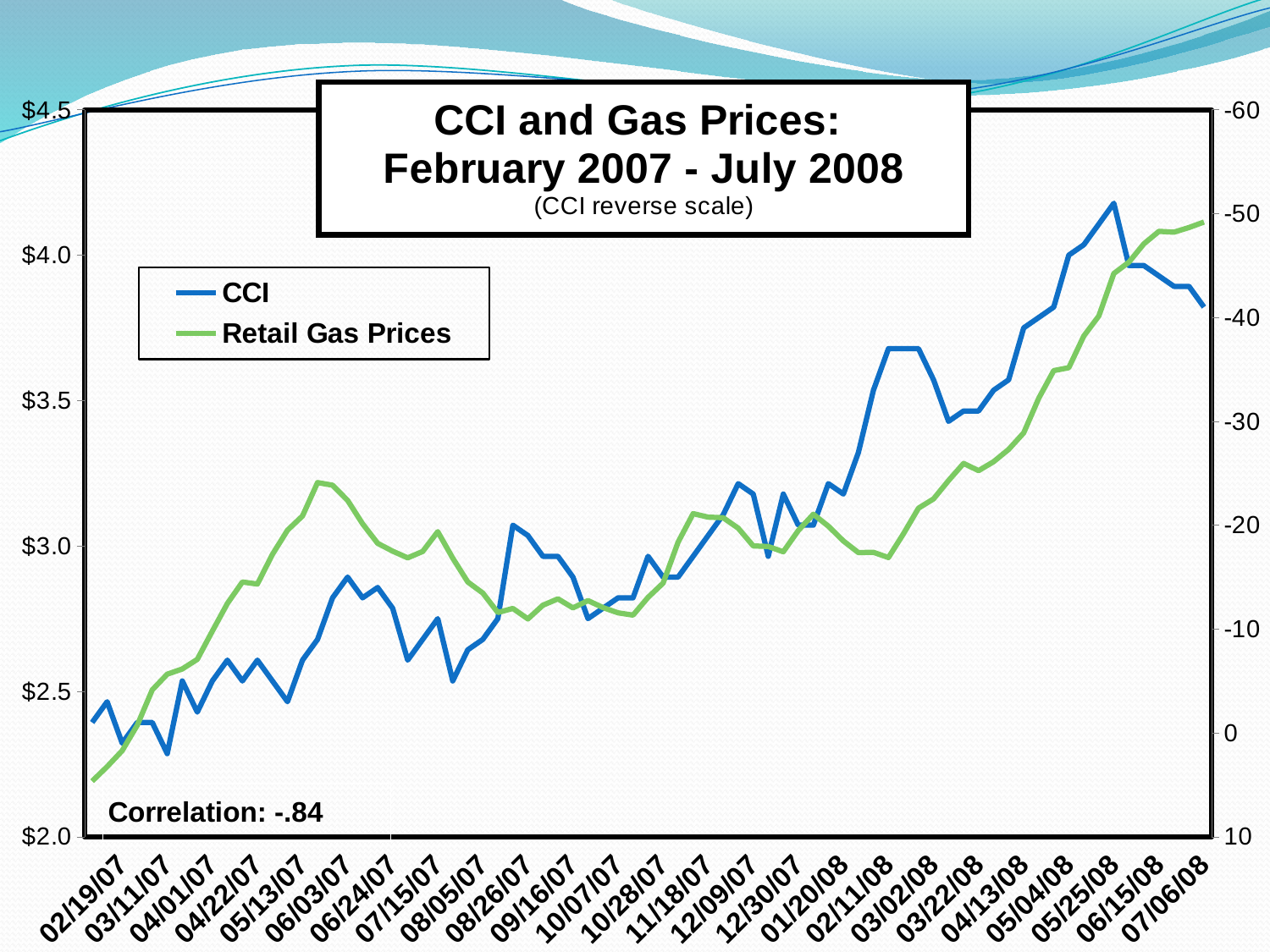
What kind of chart is shown on the slide? line chart What correlation value is printed on the chart? -.84 Is the Retail Gas Prices value at 07/06/08 greater or less than $4.0? greater Which is larger, the Retail Gas Prices value at 06/03/07 or at 10/07/07? 06/03/07 Which date has the highest Retail Gas Prices value? 07/06/08 Is the Retail Gas Prices value at 02/19/07 greater or less than $2.5? less How many series does the legend list? 2 Do Retail Gas Prices rise or fall overall from 02/19/07 to 07/06/08? rise What are the two series named in the legend? CCI and Retail Gas Prices How many date labels are shown along the x axis? 25 Is the Retail Gas Prices value at 06/03/07 greater or less than $3.0? greater